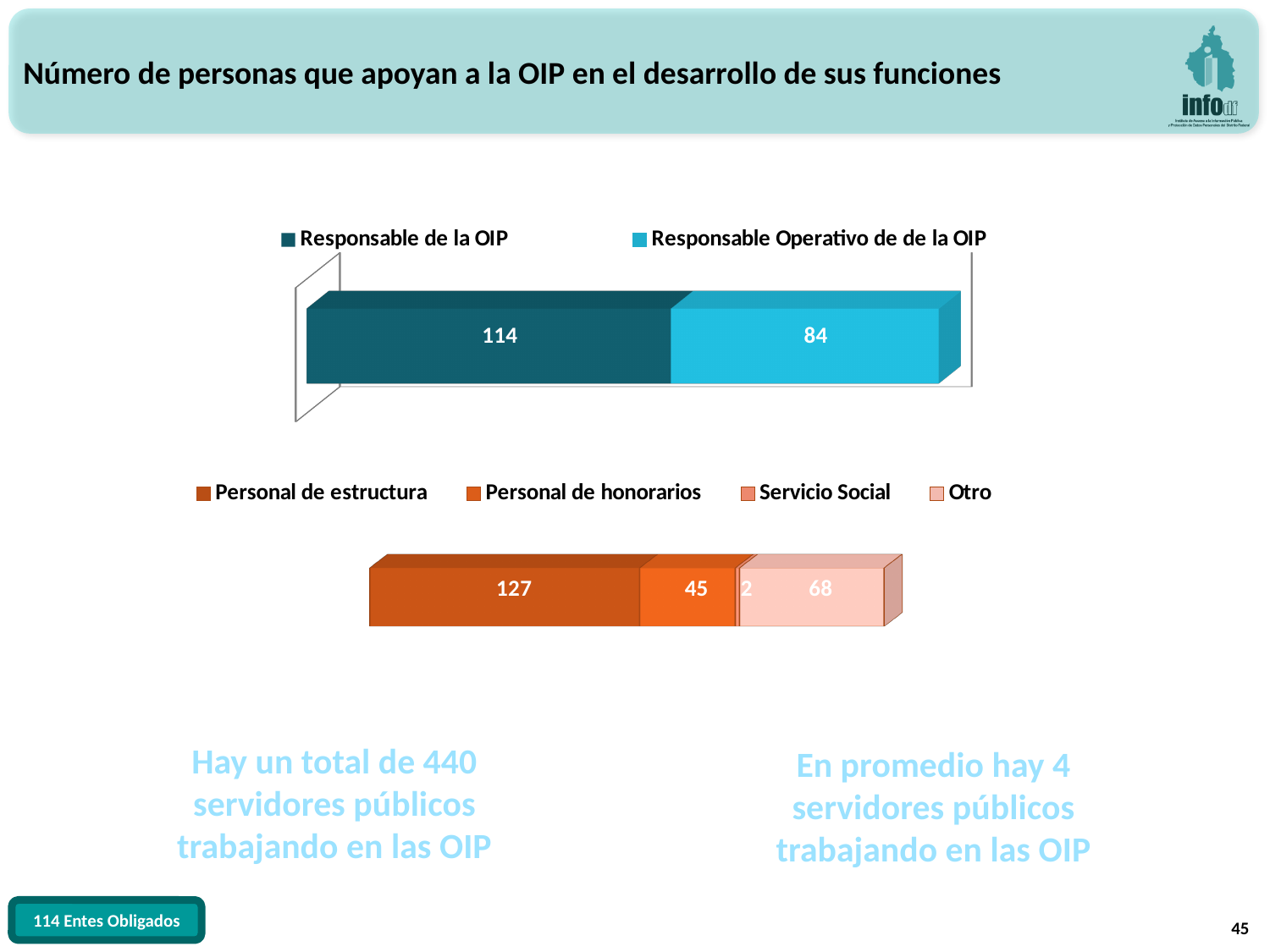
In the bottom chart, which series has the highest value? Personal de estructura In the top chart, what is the value for Responsable de la OIP? 114 How many series does the legend of the top chart list? 2 In the top chart, what is the total of the stacked bar? 198 In the top chart, what is the value for Responsable Operativo de de la OIP? 84 In the bottom chart, what is the value for Otro? 68 In the top chart, what is the difference between Responsable de la OIP and Responsable Operativo de de la OIP? 30 In the bottom chart, what is the value for Personal de estructura? 127 What kind of chart is the bottom chart? Stacked bar chart In the bottom chart, what is the value for Personal de honorarios? 45 In the bottom chart, which series has the lowest value? Servicio Social In the bottom chart, what is the total of the stacked bar? 242